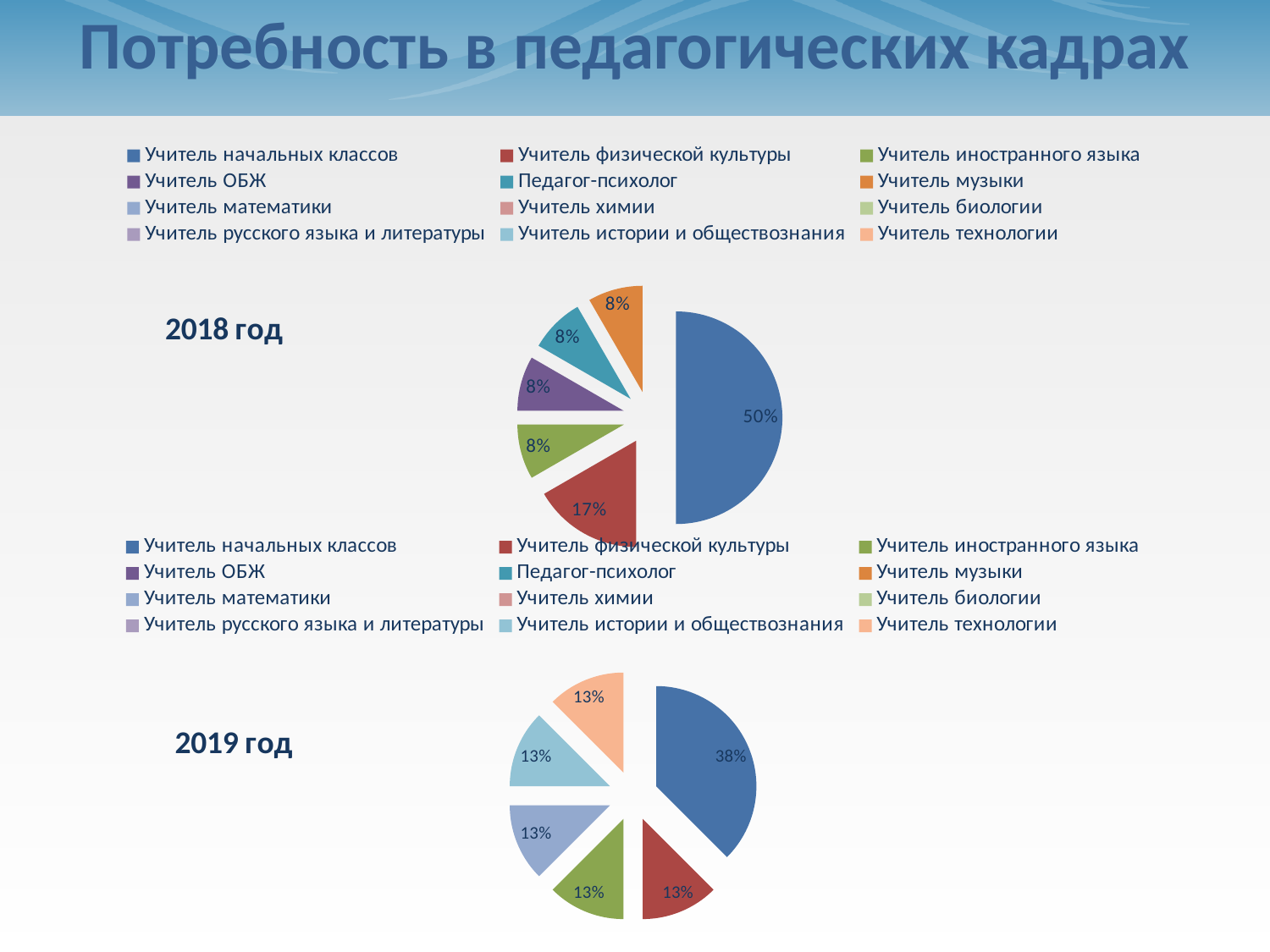
What type of chart is used for the 2019 год data? Pie chart In the 2019 год chart, what share is shown for Учитель начальных классов? 38% In the 2018 год chart, how many slices does the pie have? 6 In the 2018 год chart, what share is shown for Учитель физической культуры? 17% Which is larger: the share for Учитель начальных классов in the 2018 год chart or in the 2019 год chart? 2018 год In the 2019 год chart, which category has the largest slice? Учитель начальных классов In the 2018 год chart, what is the difference between the shares for Учитель начальных классов and Учитель физической культуры? 33% In the 2019 год chart, what share is shown for Учитель технологии? 13% In the 2018 год chart, which category has the largest slice? Учитель начальных классов How many entries does the legend above the 2018 год chart list? 12 In the 2019 год chart, how many slices does the pie have? 6 In the 2018 год chart, what share is shown for Учитель начальных классов? 50%